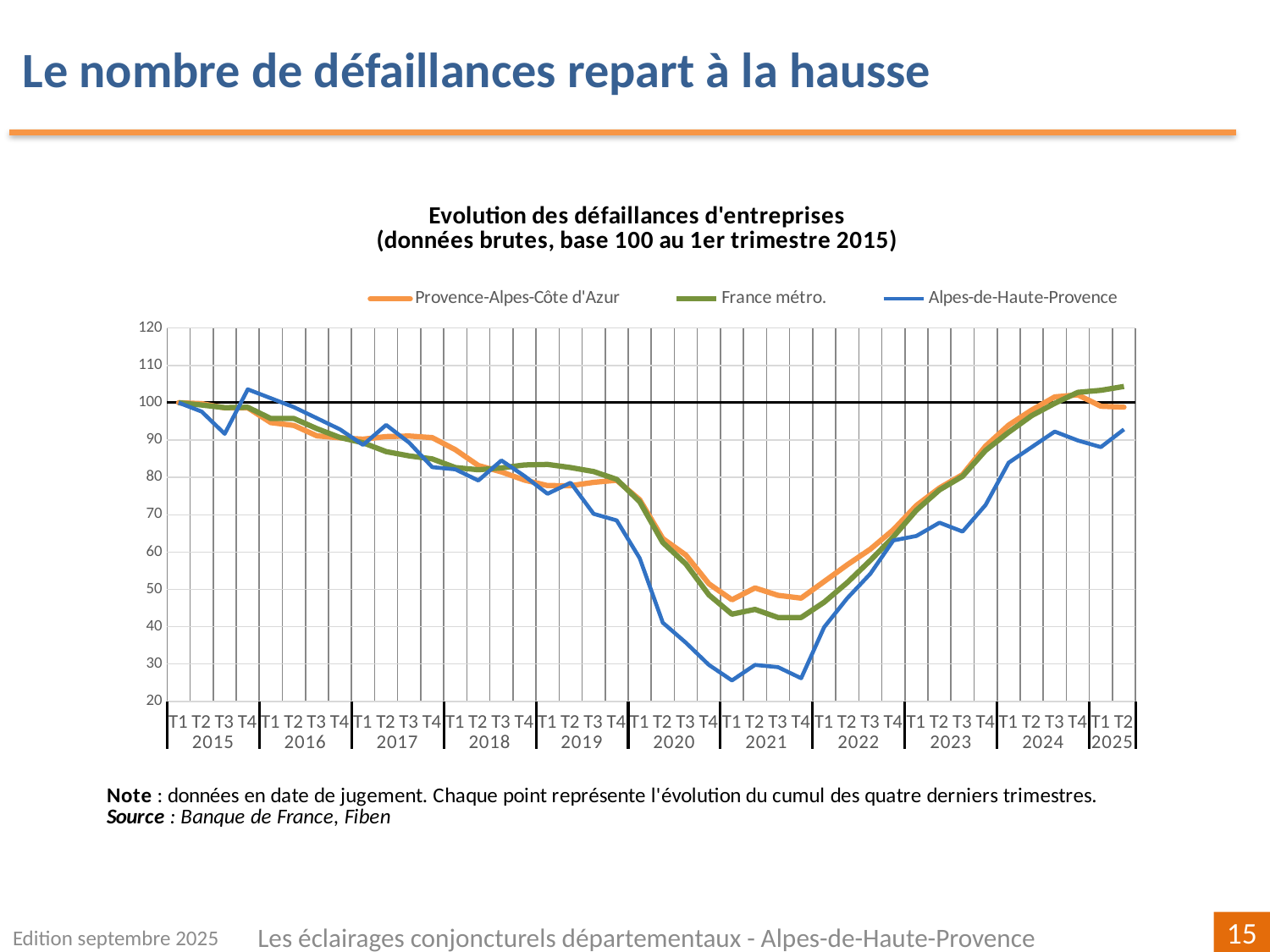
Is the value for France métro. at T2 2025 greater or less than 100? greater How many series does the legend list? 3 Is the value for France métro. at T1 2021 greater or less than 50? less What is the value of all three series at T1 2015? 100 Is the value for Alpes-de-Haute-Provence at T1 2021 greater or less than 30? less Which series has the highest value at T2 2025? France métro. Do the values for Alpes-de-Haute-Provence rise or fall between T1 2021 and T4 2024? rise Which series has the lowest value at T1 2021? Alpes-de-Haute-Provence At T4 2015, which is higher: Alpes-de-Haute-Provence or France métro.? Alpes-de-Haute-Provence Which colour is used for the Provence-Alpes-Côte d'Azur line? orange What kind of chart is shown on the slide? line chart How many years are labelled on the x axis? 11